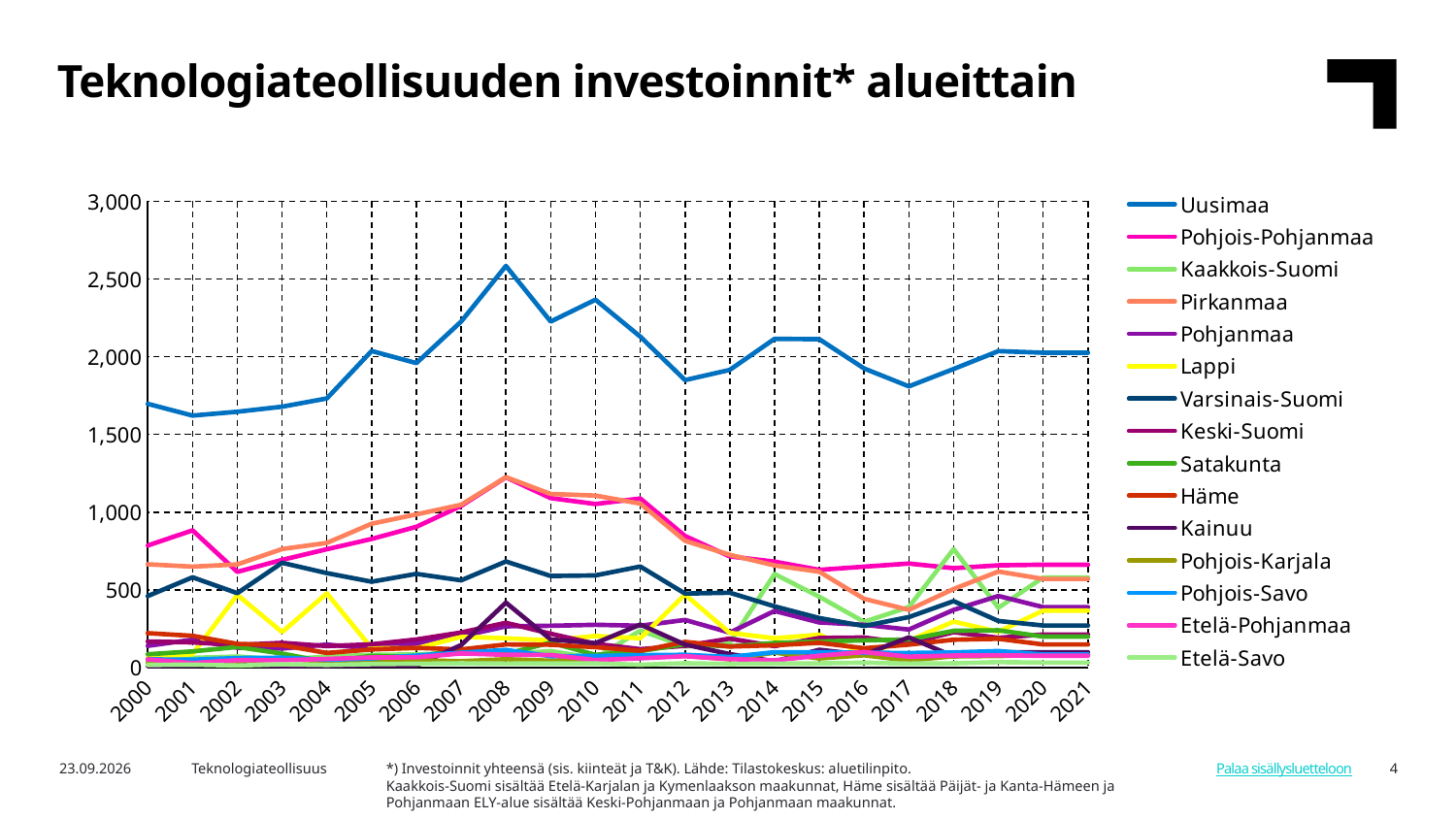
In which year does the Uusimaa line reach its highest point? 2008 Is the value for Uusimaa in 2000 greater or less than 1,500? greater Is the value for Uusimaa in 2008 greater or less than 2,500? greater What kind of chart is shown on the slide? line chart Is the value for Uusimaa in 2012 greater or less than 2,000? less Which region has the highest values across the whole period? Uusimaa How many years are plotted along the x axis? 22 Which is larger in 2008, the value for Uusimaa or the value for Pirkanmaa? Uusimaa How many series does the legend list? 15 What is the title of the chart on the slide? Teknologiateollisuuden investoinnit* alueittain